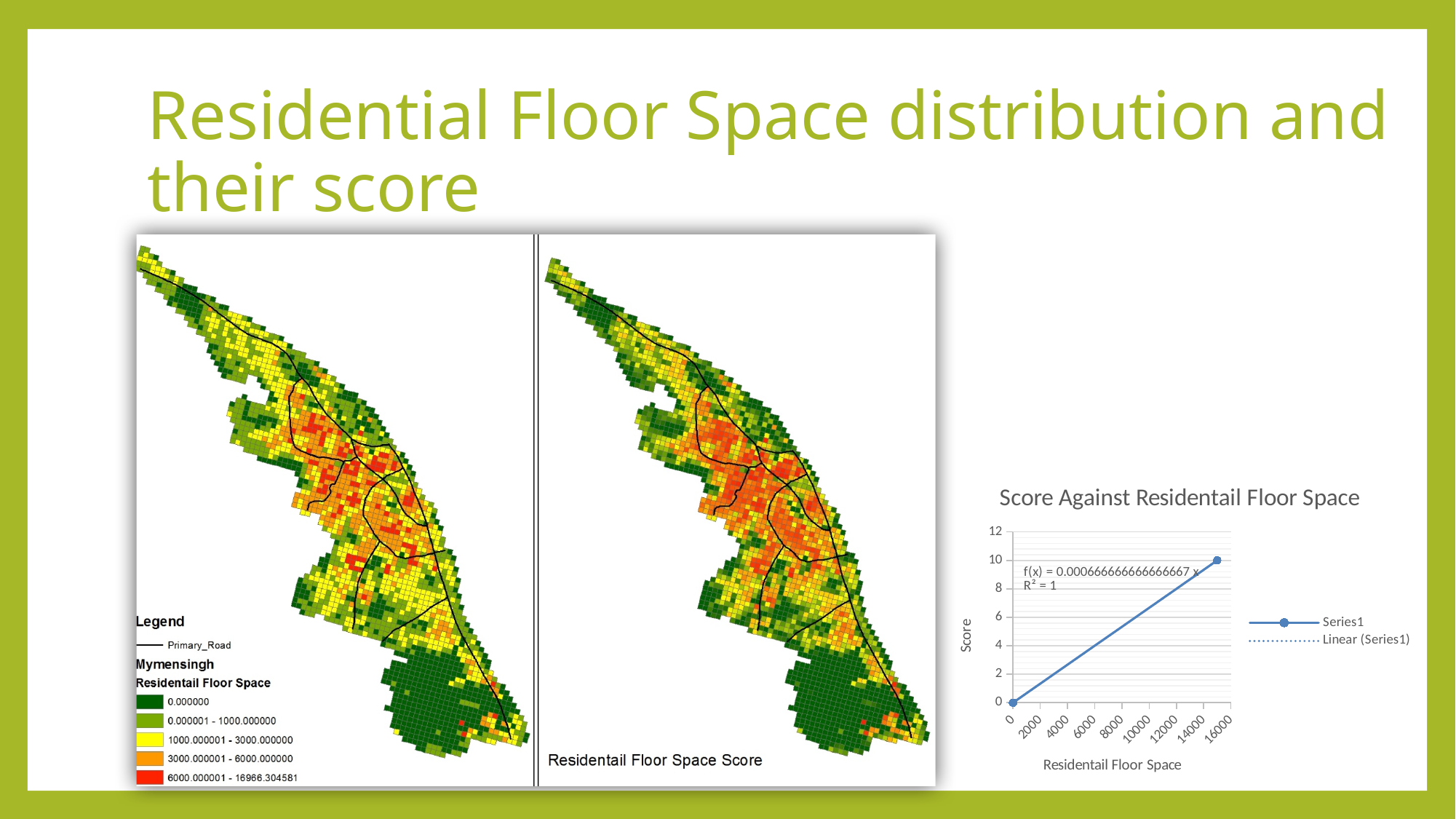
What kind of chart is "Score Against Residentail Floor Space"? scatter chart In the "Score Against Residentail Floor Space" chart, is the residential floor space value of the highest point greater or less than 16000? less How many series does the legend of the "Score Against Residentail Floor Space" chart list? 2 What is the maximum value shown on the vertical axis of the "Score Against Residentail Floor Space" chart? 12 What is the lowest score value plotted in the "Score Against Residentail Floor Space" chart? 0 How many data points are plotted in the "Score Against Residentail Floor Space" chart? 2 What is the R² value shown on the "Score Against Residentail Floor Space" chart? 1 In the "Score Against Residentail Floor Space" chart, is the residential floor space value of the highest point greater or less than 14000? greater What is the label of the vertical axis in the "Score Against Residentail Floor Space" chart? Score In the "Score Against Residentail Floor Space" chart, does the score rise or fall as residential floor space increases? rises What is the highest score value plotted in the "Score Against Residentail Floor Space" chart? 10